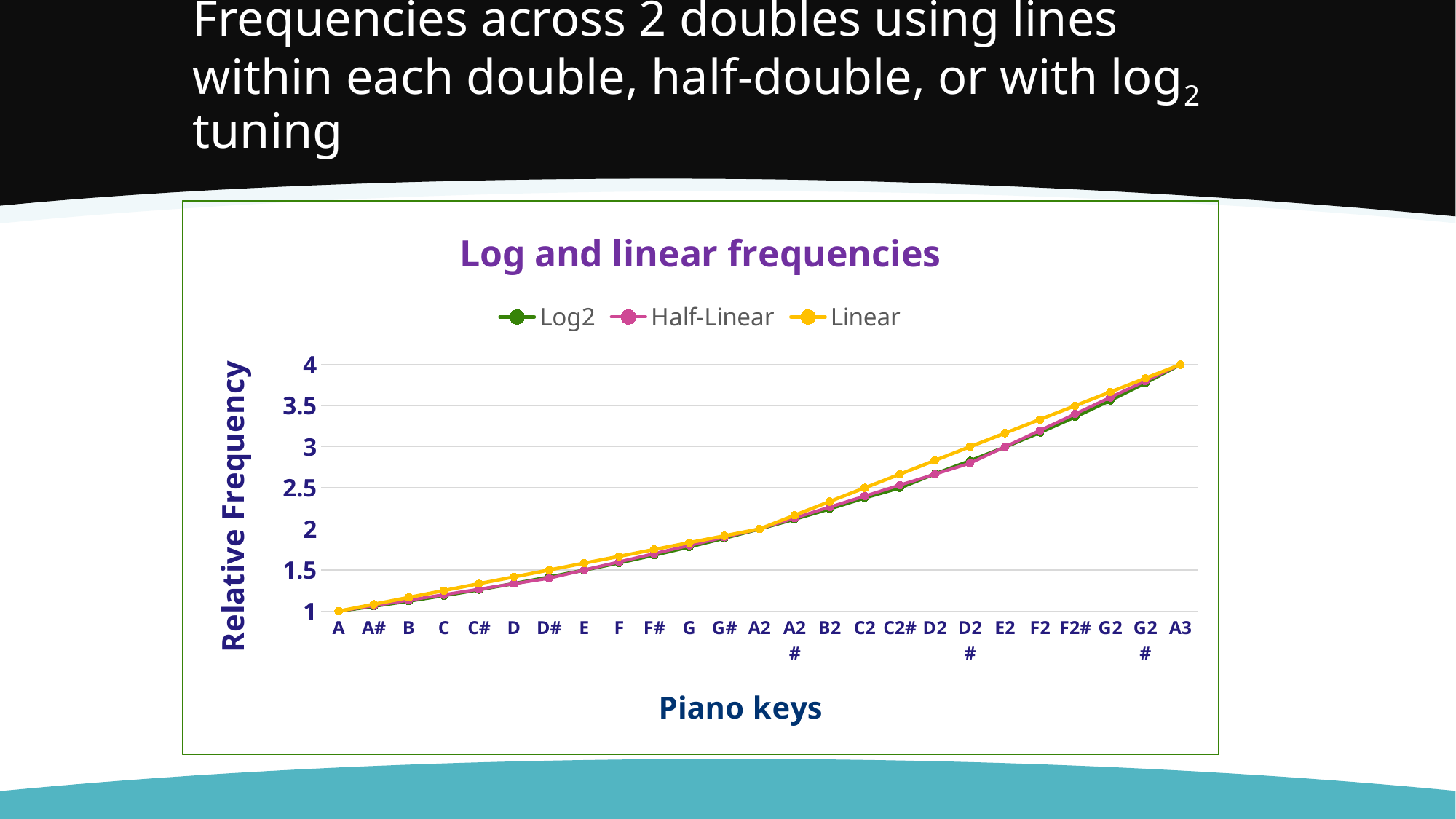
What is the relative frequency of the Linear series at key A3? 4 Is the Log2 value at key D2 greater or less than 3? less How many series does the legend list? 3 What is the relative frequency of the Log2 series at key A2? 2 What kind of chart is shown on the slide? line chart What is the label of the y axis? Relative Frequency Do the relative frequency values rise or fall from key A to key A3? rise How many piano keys are shown along the x axis? 25 What is the relative frequency of the Linear series at key D2#? 3 Which piano key has the highest relative frequency for the Linear series? A3 What is the title of the chart? Log and linear frequencies Which piano key has the lowest relative frequency for the Log2 series? A